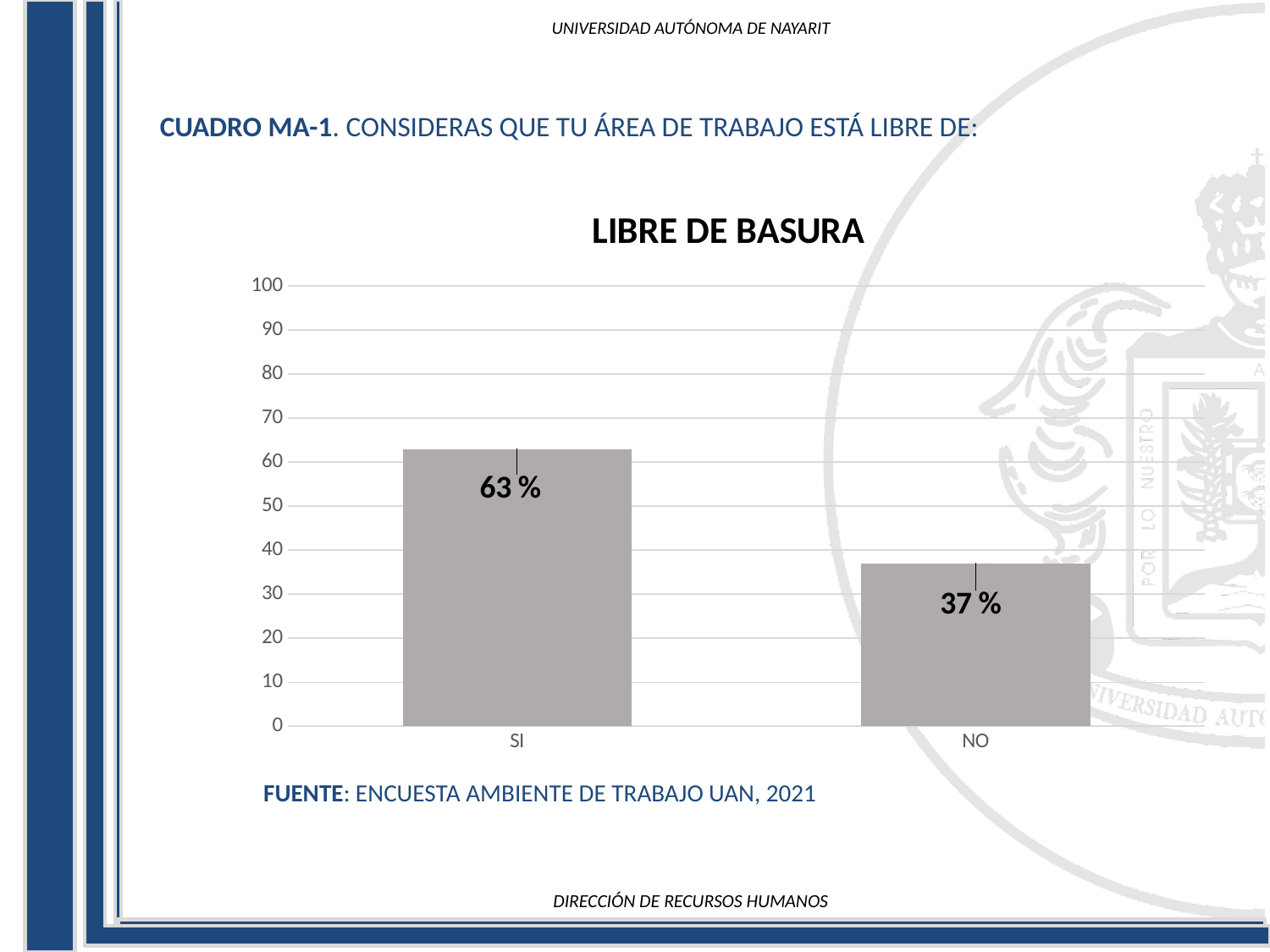
What is the maximum value shown on the y axis? 100 What is the value for NO? 37 % What is the value for SI? 63 % Which category has the highest value? SI What is the title of the chart? LIBRE DE BASURA Is the value for NO greater or less than 40? less What is the difference between the values for SI and NO? 26 % Is the value for SI greater or less than 50? greater How many categories are shown on the x axis? 2 Which category has the lowest value? NO What kind of chart is shown on the slide? bar chart Which is larger, the value for SI or the value for NO? SI